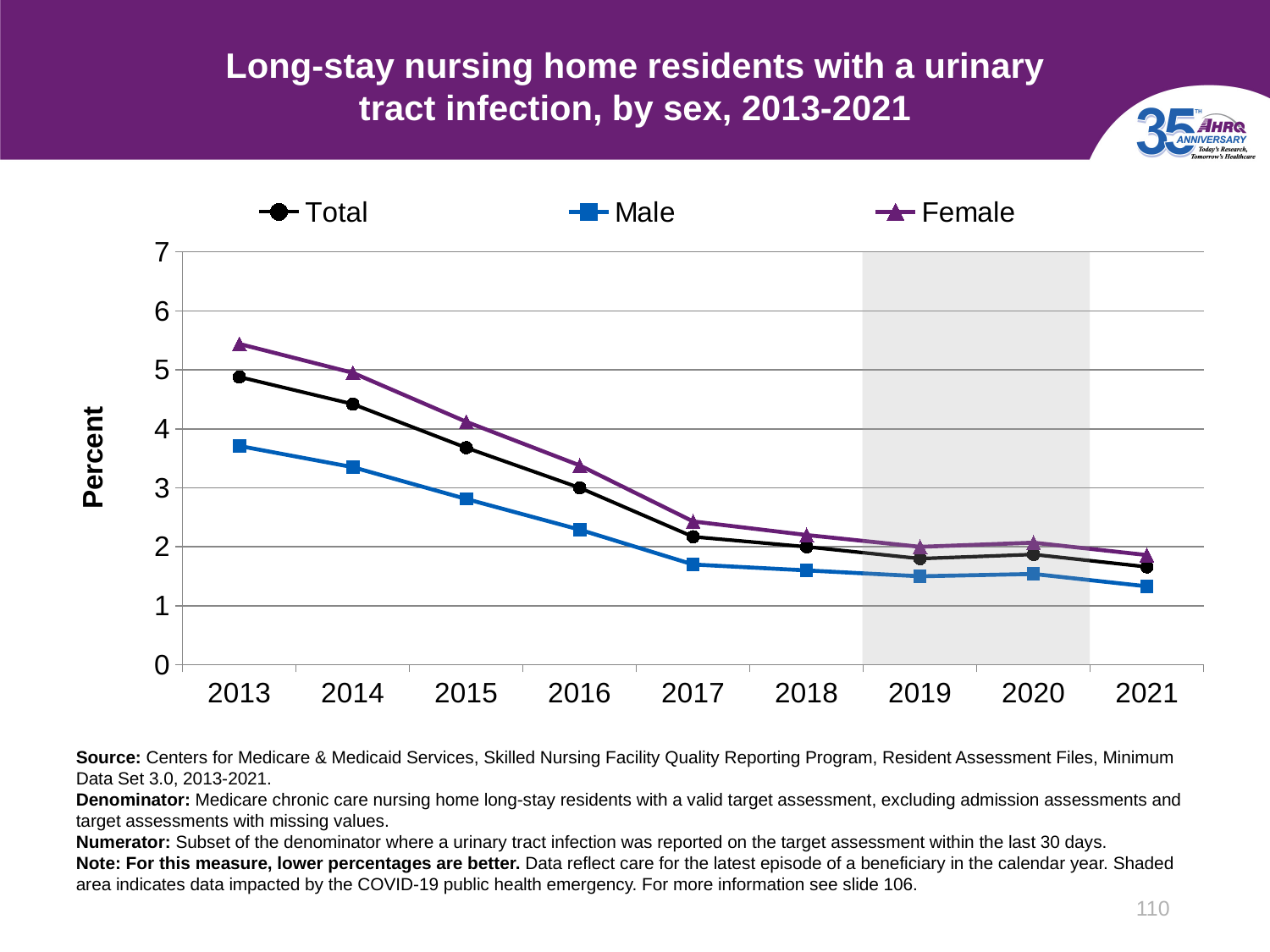
Do the values for the Total series rise or fall from 2013 to 2021? fall In which year is the Male series at its highest? 2013 What kind of chart is shown on the slide? line chart Which series has the highest value in 2013? Female How many years are plotted along the x axis? 9 Is the value for Male in 2013 greater or less than 4? less What is the label on the y axis? Percent How many series does the legend list? 3 Is the value for Male in 2018 greater or less than 2? less Is the value for Female in 2013 greater or less than 5? greater Which is larger in 2016, the value for Female or the value for Male? Female Which series has the lowest value in 2021? Male